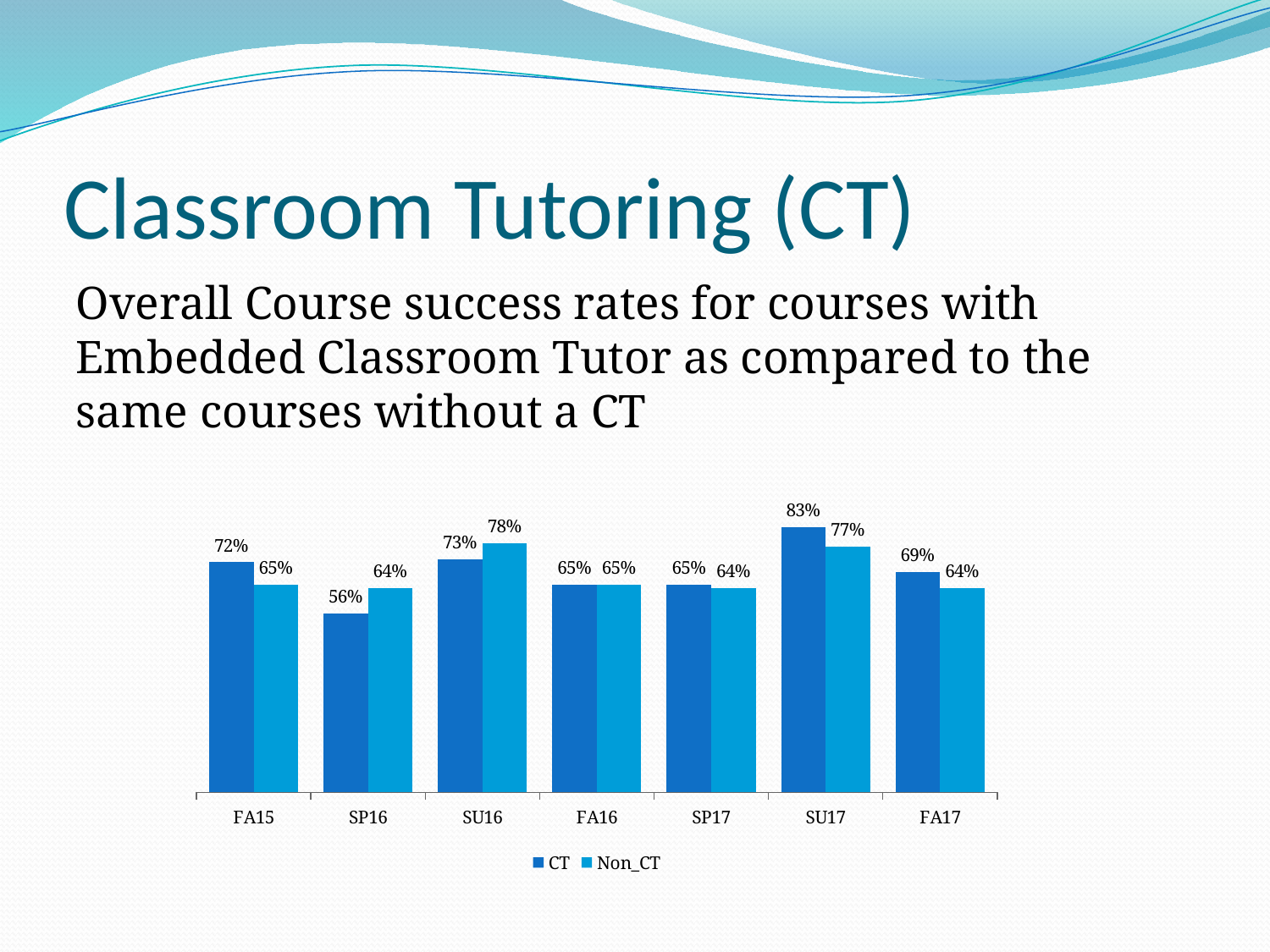
What are the two series named in the legend? CT and Non_CT What is the difference between the CT and Non_CT success rates for SU17? 6% What is the CT success rate for FA15? 72% Which is larger for SP16, the CT rate or the Non_CT rate? Non_CT What is the Non_CT success rate for SU16? 78% What is the CT success rate for SP16? 56% What kind of chart is shown on the slide? Bar chart Which term has the highest CT success rate? SU17 How many series does the legend list? 2 Which term has the lowest CT success rate? SP16 What is the difference between the CT rates for SU17 and SP16? 27% How many terms are shown on the x axis? 7